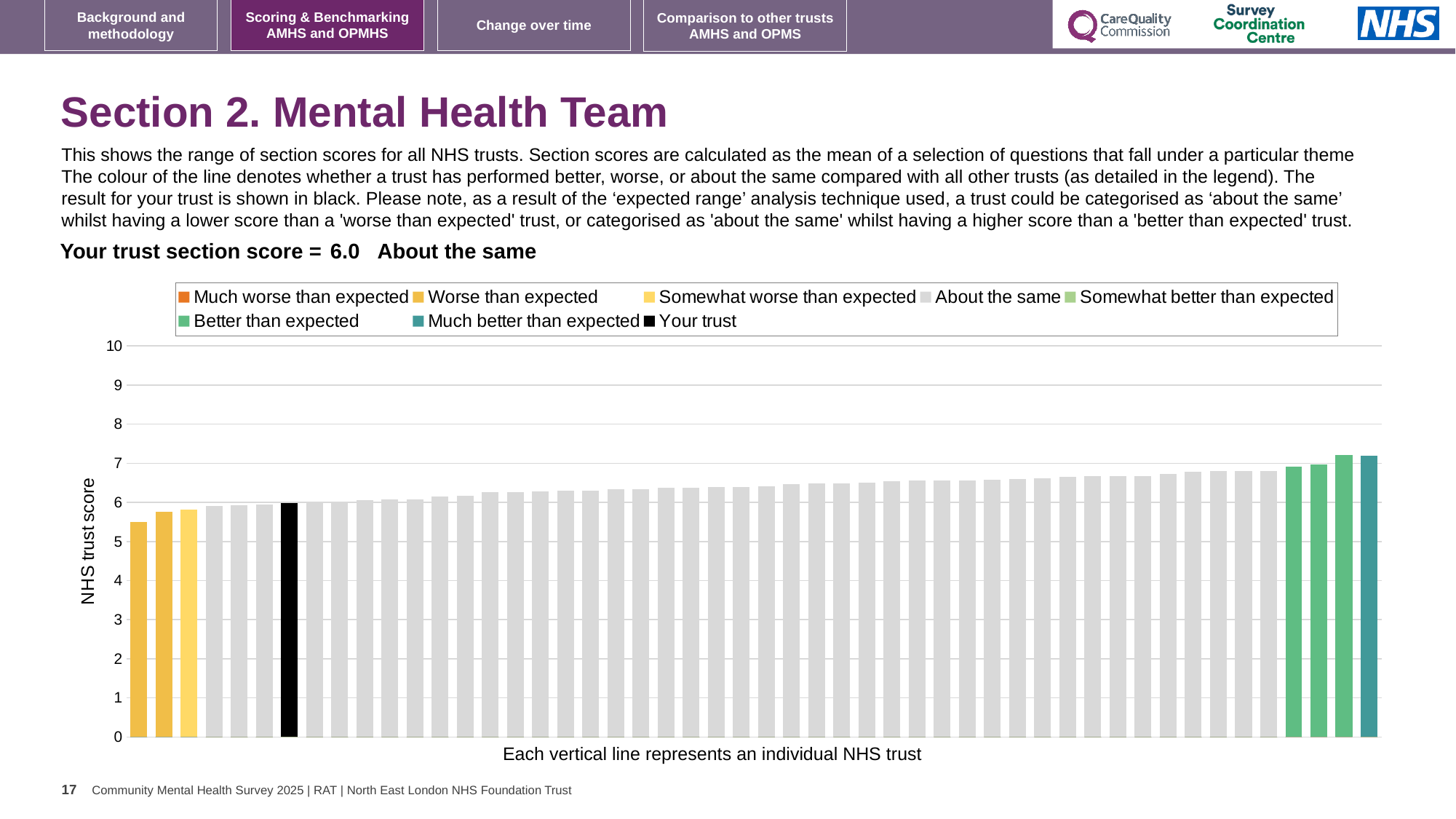
What colour is the bar representing your trust? black What kind of chart is shown on the slide? bar chart How many entries does the chart legend list? 8 Which category is your trust placed in according to the slide? About the same What is the section score for your trust shown on the slide? 6.0 What is the title of the vertical axis? NHS trust score Is the value for your trust (the black bar) greater or less than 7? less Do the bar values rise or fall from left to right along the x axis? rise Is the value for the leftmost bar greater or less than 5? greater Is the value for the rightmost bar greater or less than 6? greater